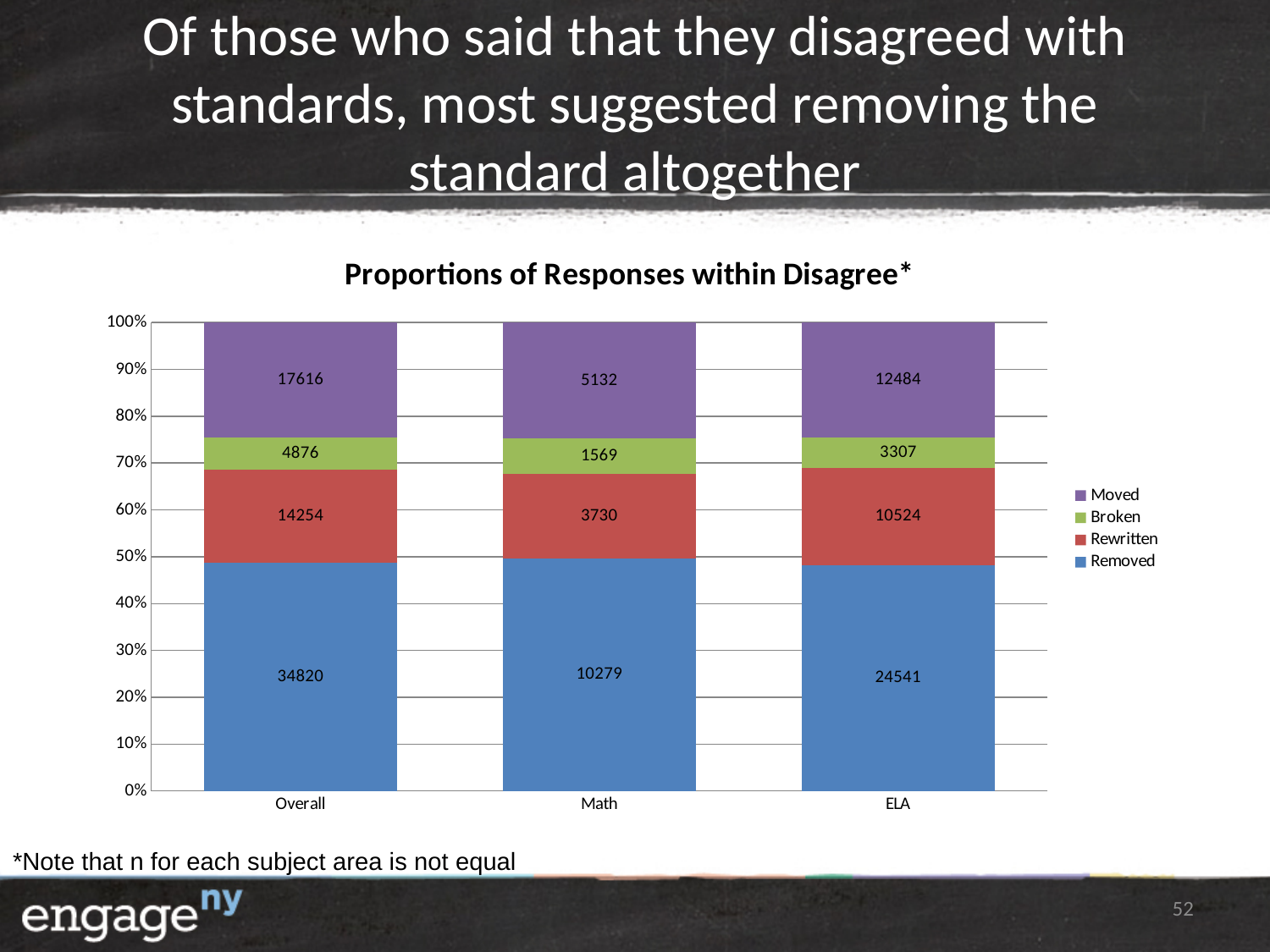
Which is larger in the ELA bar: the Rewritten value or the Moved value? Moved Is the Removed segment of the ELA bar greater or less than 40% of the bar? greater How many series does the legend list? 4 What is the data label for the Broken segment of the ELA bar? 3307 What is the data label for the Removed segment of the Overall bar? 34820 What kind of chart is shown on the slide? Stacked bar chart What is the total of the four labelled values in the Math bar? 20710 What is the difference between the Moved and Broken labelled values in the Overall bar? 12740 Which response category has the smallest labelled value in the Overall bar? Broken What is the data label for the Moved segment of the Math bar? 5132 What is the data label for the Rewritten segment of the ELA bar? 10524 Which response category has the largest labelled value in the Math bar? Removed